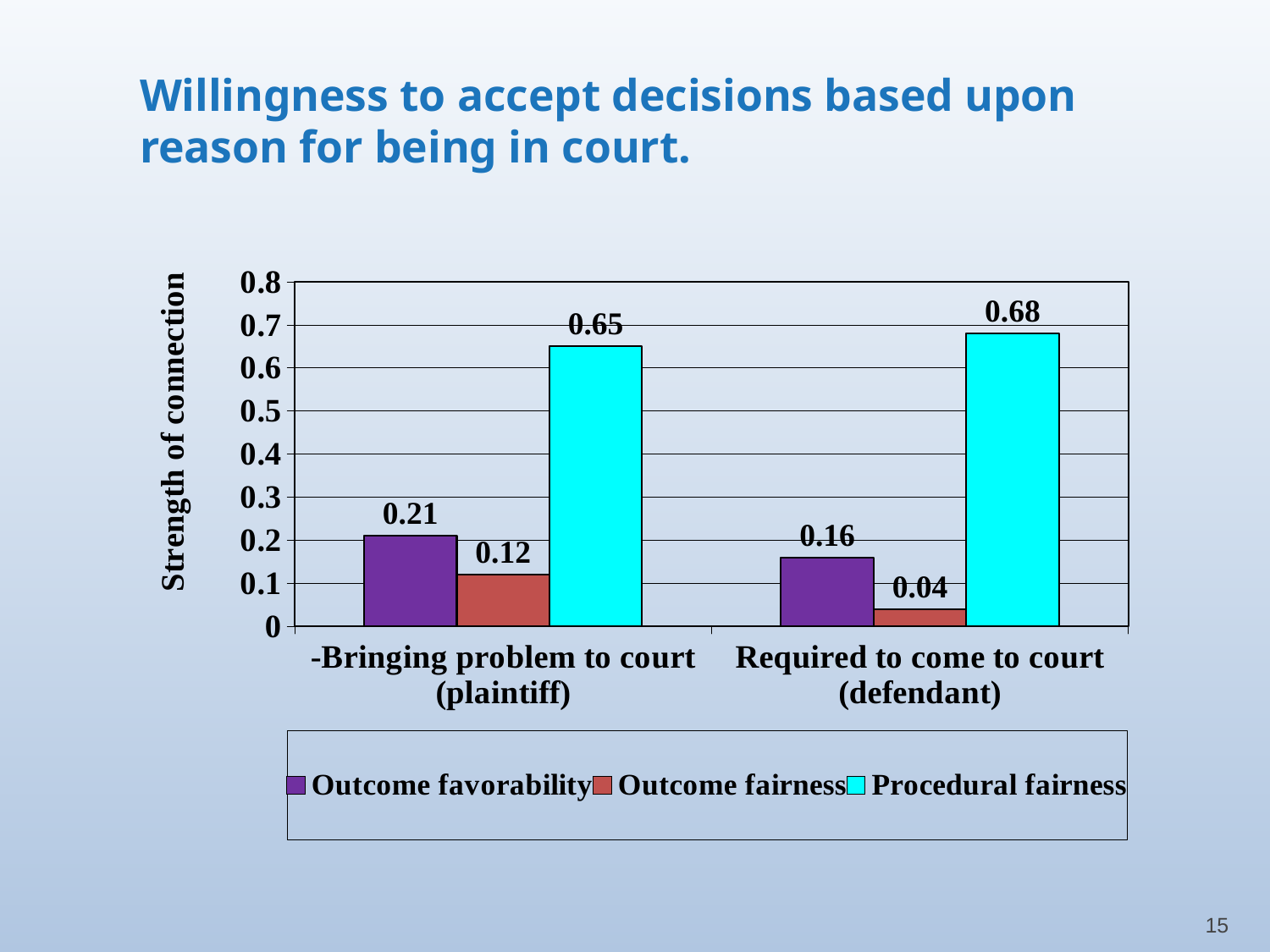
What is the value for Outcome favorability in the Bringing problem to court (plaintiff) category? 0.21 What is the value for Outcome fairness in the Required to come to court (defendant) category? 0.04 Is the value for Procedural fairness in the defendant category greater or less than 0.6? greater Which is larger: Outcome favorability for the plaintiff category or Outcome favorability for the defendant category? Plaintiff category (0.21) What kind of chart is shown on the slide? Bar chart What is the difference between the Procedural fairness values for the defendant and plaintiff categories? 0.03 What is the difference between Outcome favorability and Outcome fairness in the Required to come to court (defendant) category? 0.12 How many categories are shown on the x axis? 2 How many series does the legend list? 3 What is the value for Procedural fairness in the Bringing problem to court (plaintiff) category? 0.65 Which series has the lowest value in the Bringing problem to court (plaintiff) category? Outcome fairness Which series has the highest value in the Required to come to court (defendant) category? Procedural fairness